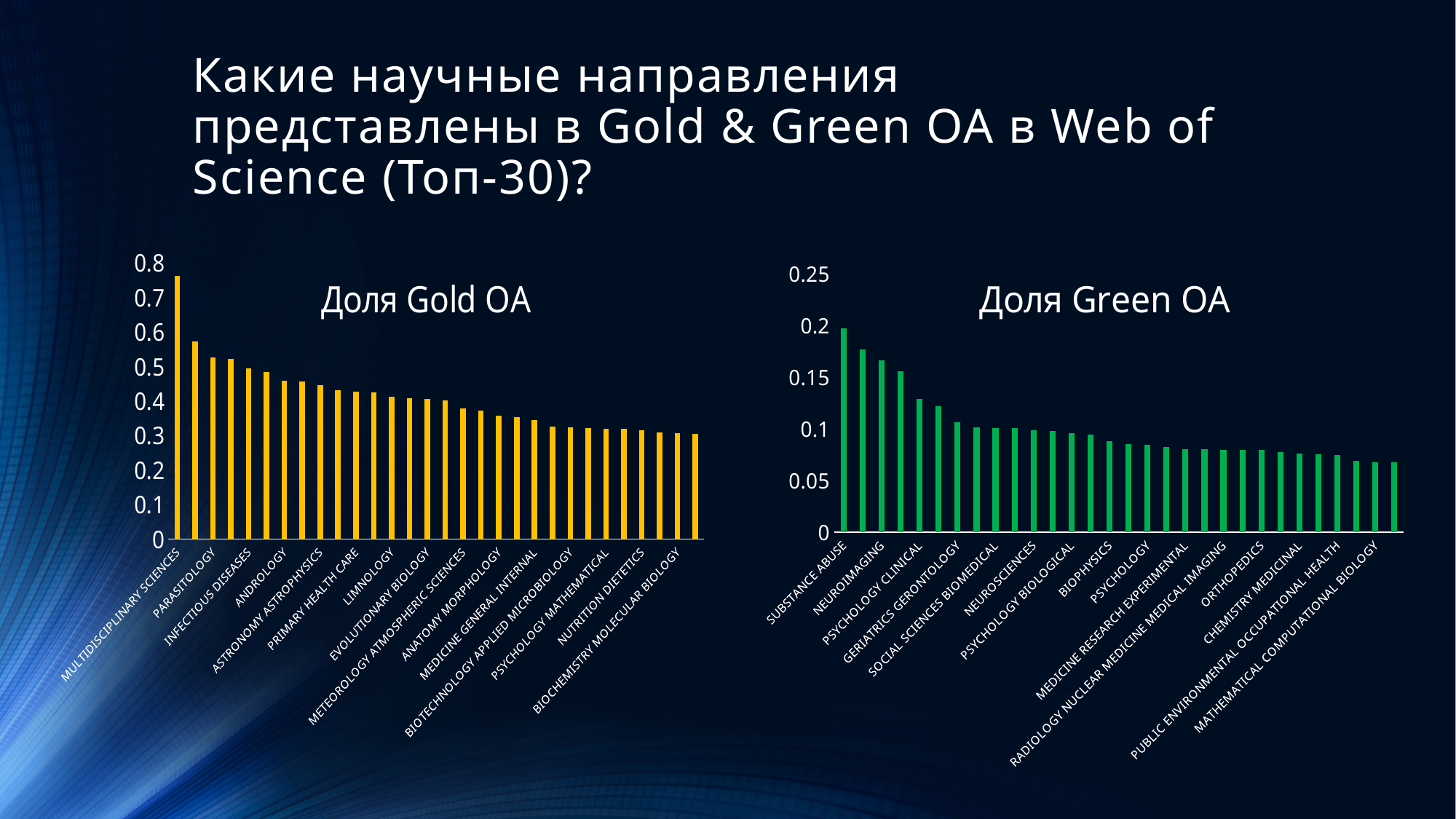
What kind of chart is the 'Доля Gold OA' chart? bar chart On the 'Доля Gold OA' chart, which is larger: PARASITOLOGY or ANDROLOGY? PARASITOLOGY On the 'Доля Green OA' chart, is the value for MATHEMATICAL COMPUTATIONAL BIOLOGY greater or less than 0.1? less How many bars are plotted on the 'Доля Green OA' chart? 30 On the 'Доля Green OA' chart, which is larger: NEUROIMAGING or ORTHOPEDICS? NEUROIMAGING What colour are the bars on the 'Доля Green OA' chart? green On the 'Доля Gold OA' chart, is the value for MULTIDISCIPLINARY SCIENCES greater or less than 0.7? greater On the 'Доля Gold OA' chart, which category has the highest value? MULTIDISCIPLINARY SCIENCES On the 'Доля Gold OA' chart, is the value for BIOCHEMISTRY MOLECULAR BIOLOGY greater or less than 0.4? less On the 'Доля Gold OA' chart, do the values rise or fall from left to right? fall On the 'Доля Green OA' chart, which category has the highest value? SUBSTANCE ABUSE